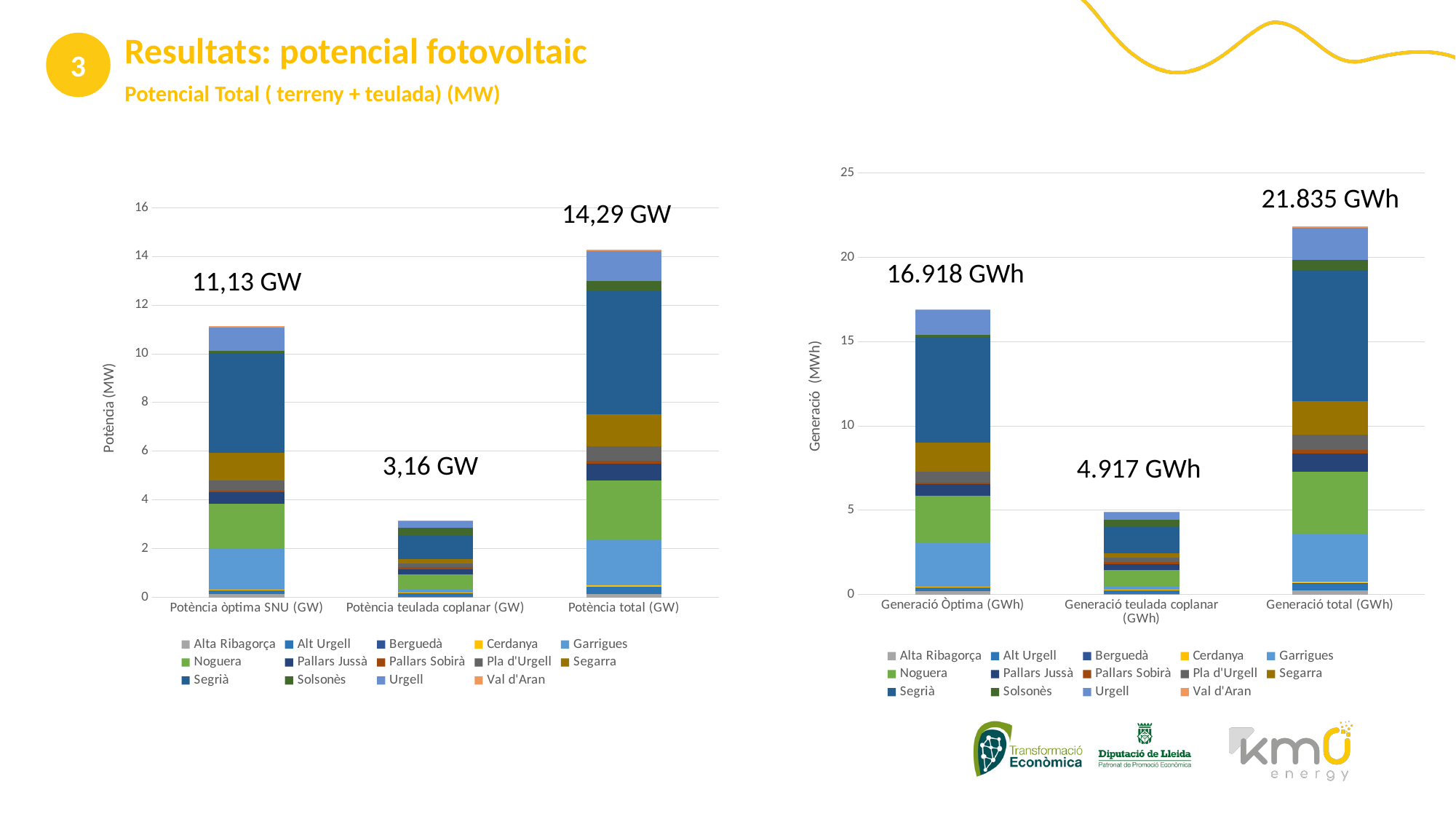
What kind of chart is the left chart? Stacked bar chart In the right chart, is the total for 'Generació teulada coplanar (GWh)' greater or less than 5? less In the left chart, what is the difference between the totals of 'Potència total (GW)' and 'Potència òptima SNU (GW)'? 3,16 GW In the left chart, which category has the lowest total? Potència teulada coplanar (GW) In the right chart, what is the total labelled above the 'Generació Òptima (GWh)' bar? 16.918 GWh In the right chart, what is the difference between the totals of 'Generació total (GWh)' and 'Generació Òptima (GWh)'? 4.917 GWh In the left chart, what is the total labelled above the 'Potència total (GW)' bar? 14,29 GW How many series does the legend of the left chart list? 14 How many categories are shown on the x axis of the right chart? 3 In the right chart, what is the total labelled above the 'Generació total (GWh)' bar? 21.835 GWh In the left chart, what is the total labelled above the 'Potència teulada coplanar (GW)' bar? 3,16 GW In the right chart, which category has the highest total? Generació total (GWh)